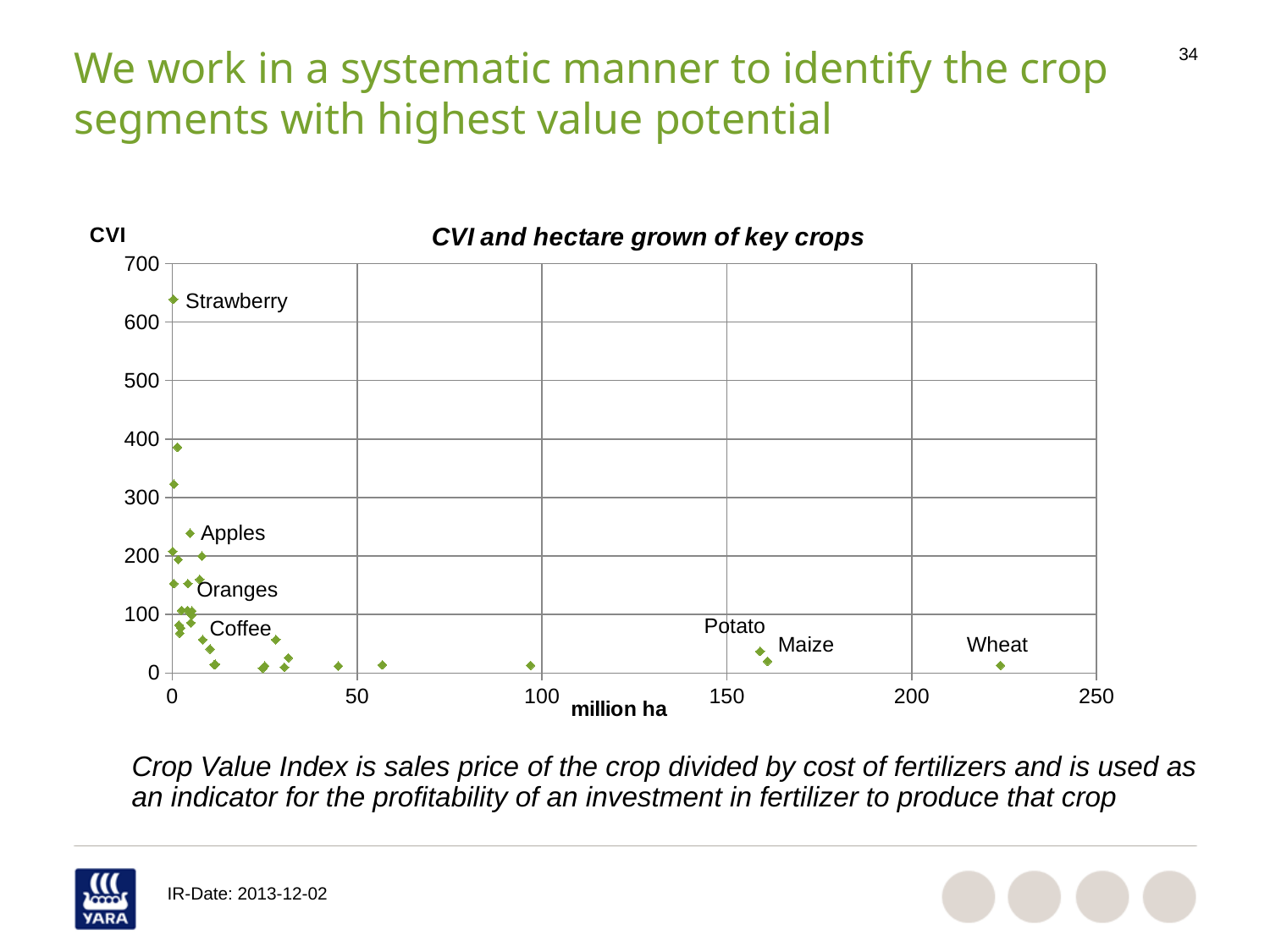
Is the CVI value for Wheat greater or less than 100? less What is the label on the horizontal axis of the chart? million ha Is the CVI value for Strawberry greater or less than 600? greater Is the CVI value for Strawberry greater or less than 700? less What is the title of the chart? CVI and hectare grown of key crops Which crop is grown on more hectares, Wheat or Maize? Wheat What kind of chart is shown on the slide? scatter chart Which labeled crop has the largest area in million ha? Wheat Which labeled crop has the highest CVI? Strawberry